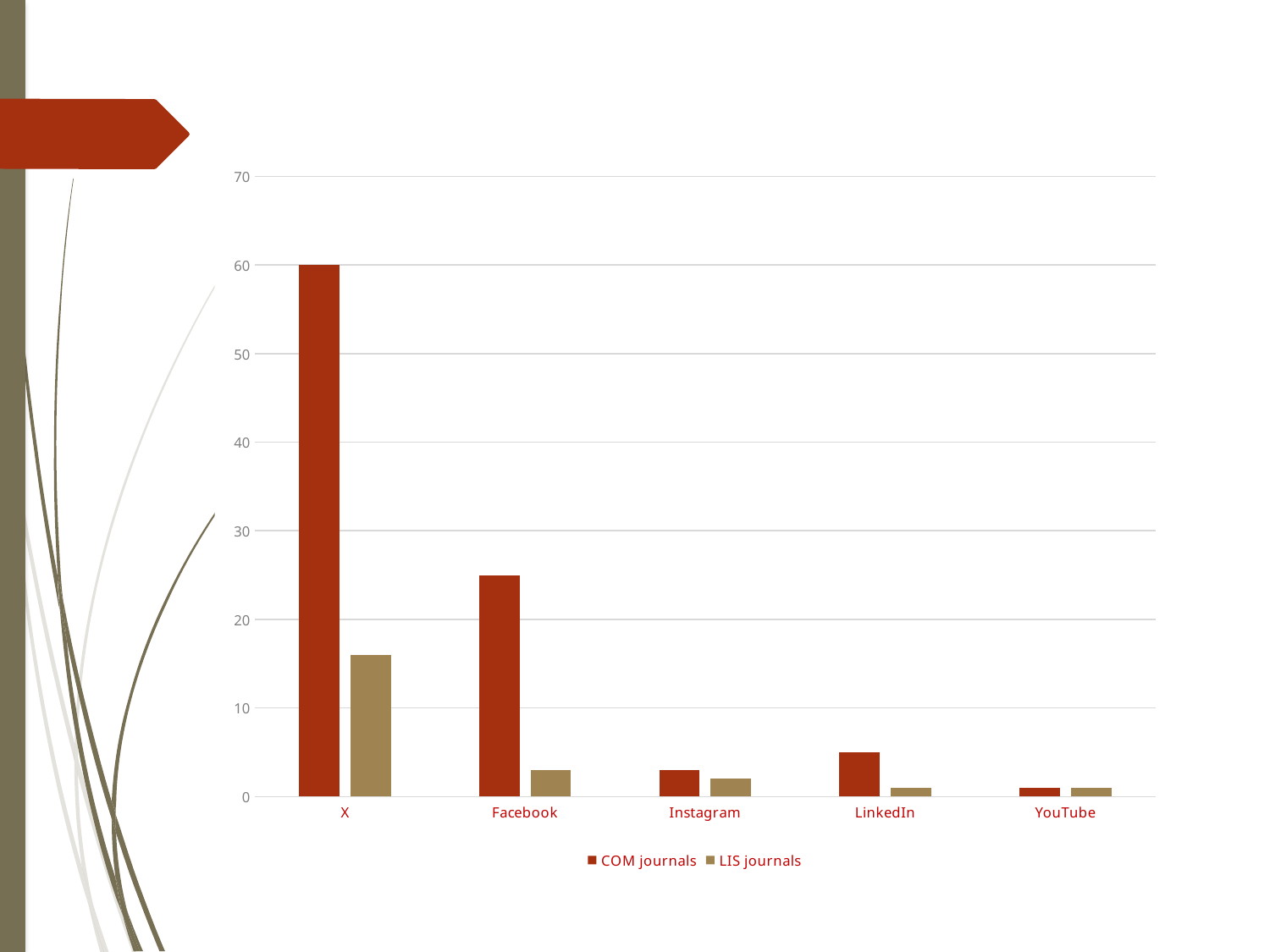
Which is larger for Facebook: COM journals or LIS journals? COM journals What kind of chart is shown on the slide? bar chart Which category has the lowest value for COM journals? YouTube What is the value for COM journals for X? 60 Which category has the highest value for COM journals? X Is the value for COM journals for Facebook greater or less than 20? greater How many series does the legend list? 2 Which is larger for COM journals: X or Facebook? X Is the value for COM journals for LinkedIn greater or less than 10? less Is the value for LIS journals for X greater or less than 10? greater Which category has the highest value for LIS journals? X How many categories are shown on the x axis? 5